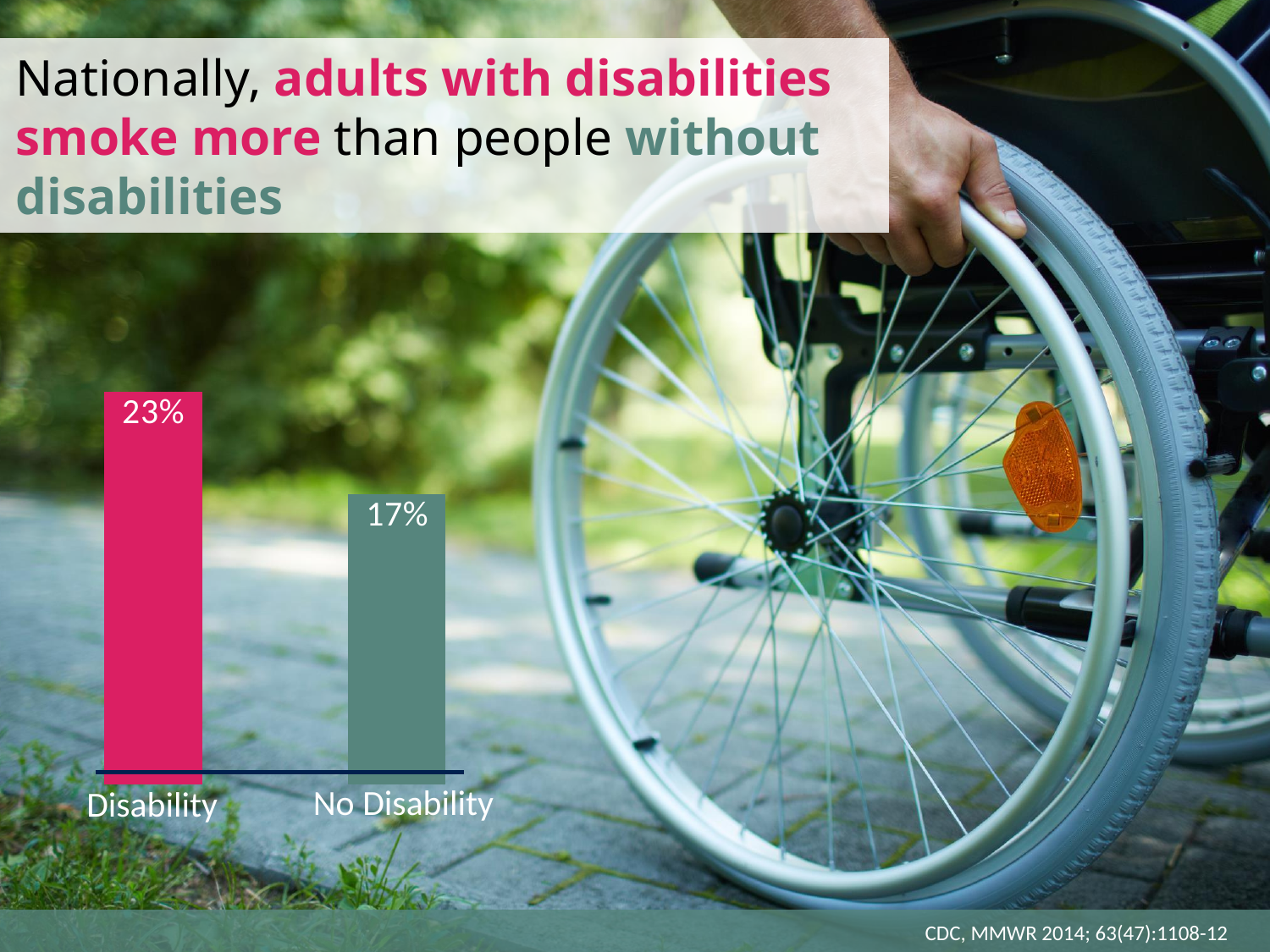
How many categories are shown in the chart? 2 What kind of chart is shown on the slide? Bar chart Which is larger, the value for Disability or the value for No Disability? Disability What source is cited for the chart data? CDC, MMWR 2014; 63(47):1108-12 What is the value for No Disability? 17% What is the difference between the values for Disability and No Disability? 6% Which category has the highest value? Disability What is the value for Disability? 23% Which category has the lowest value? No Disability What colour is the bar for Disability? Pink